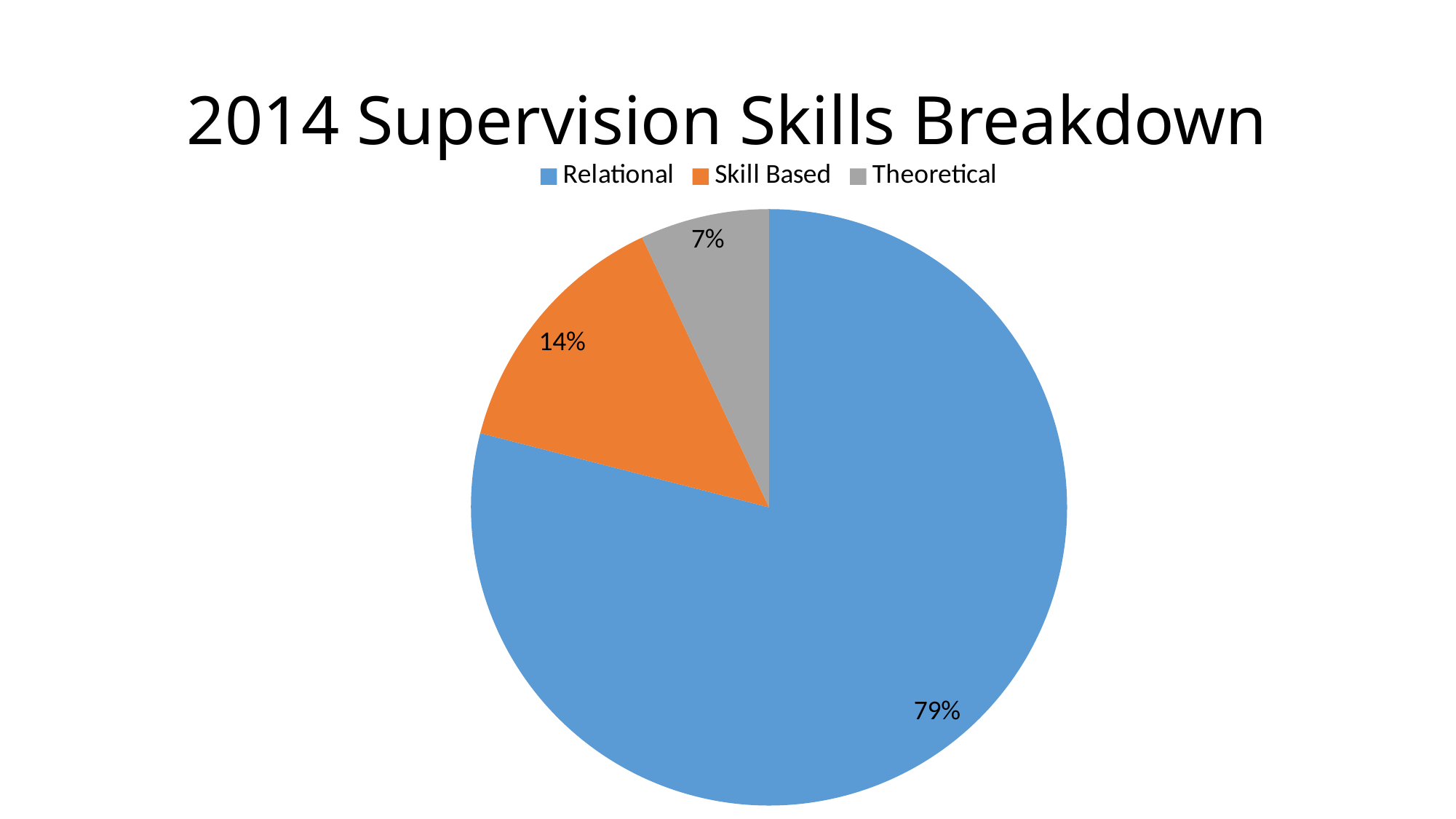
What colour is the Skill Based slice? orange What kind of chart is shown on the slide? pie chart Which category has the smallest slice? Theoretical Which category has the largest slice? Relational What share of the pie does Skill Based take? 14% Which is larger, the Skill Based slice or the Theoretical slice? Skill Based How many slices does the pie chart have? 3 How many entries does the legend list? 3 What is the difference between the Skill Based and Theoretical shares? 7% What share of the pie does Theoretical take? 7% What share of the pie does Relational take? 79% What is the title of the chart? 2014 Supervision Skills Breakdown